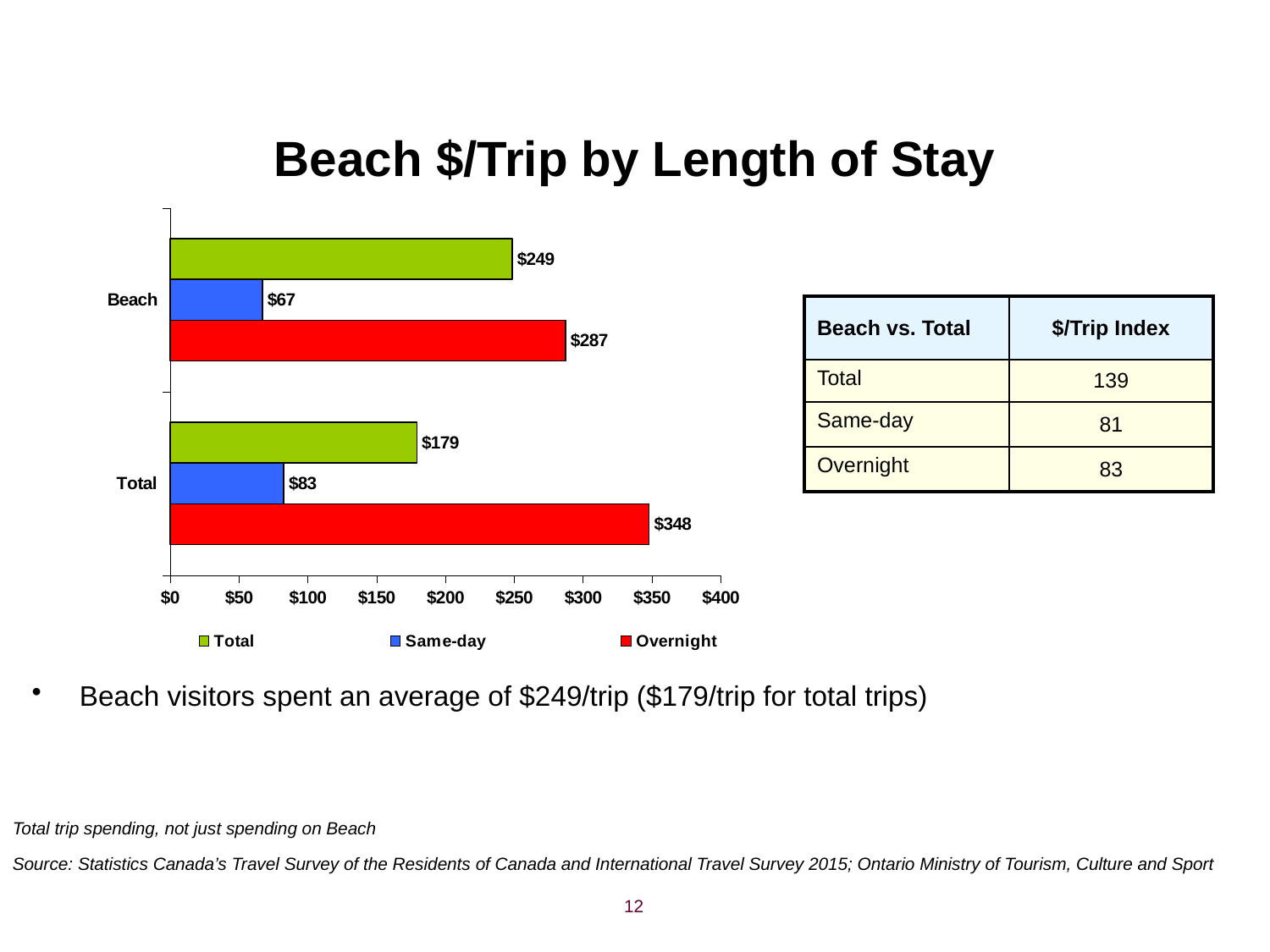
Which bar in the chart has the highest value? Overnight for Total ($348) What is the title of the chart? Beach $/Trip by Length of Stay What is the Same-day $/trip value for Total? $83 Is the Overnight value for Beach greater or less than $250? greater What is the difference between the Overnight values for Total and Beach? $61 What kind of chart is shown on the slide? Bar chart How many series does the legend list? 3 Which bar in the chart has the lowest value? Same-day for Beach ($67) What is the Total series value for the Beach category? $249 What is the difference between the Total series values for Beach and Total? $70 What is the Overnight $/trip value for Beach? $287 Which is larger, the Same-day value for Beach or the Same-day value for Total? Total ($83)